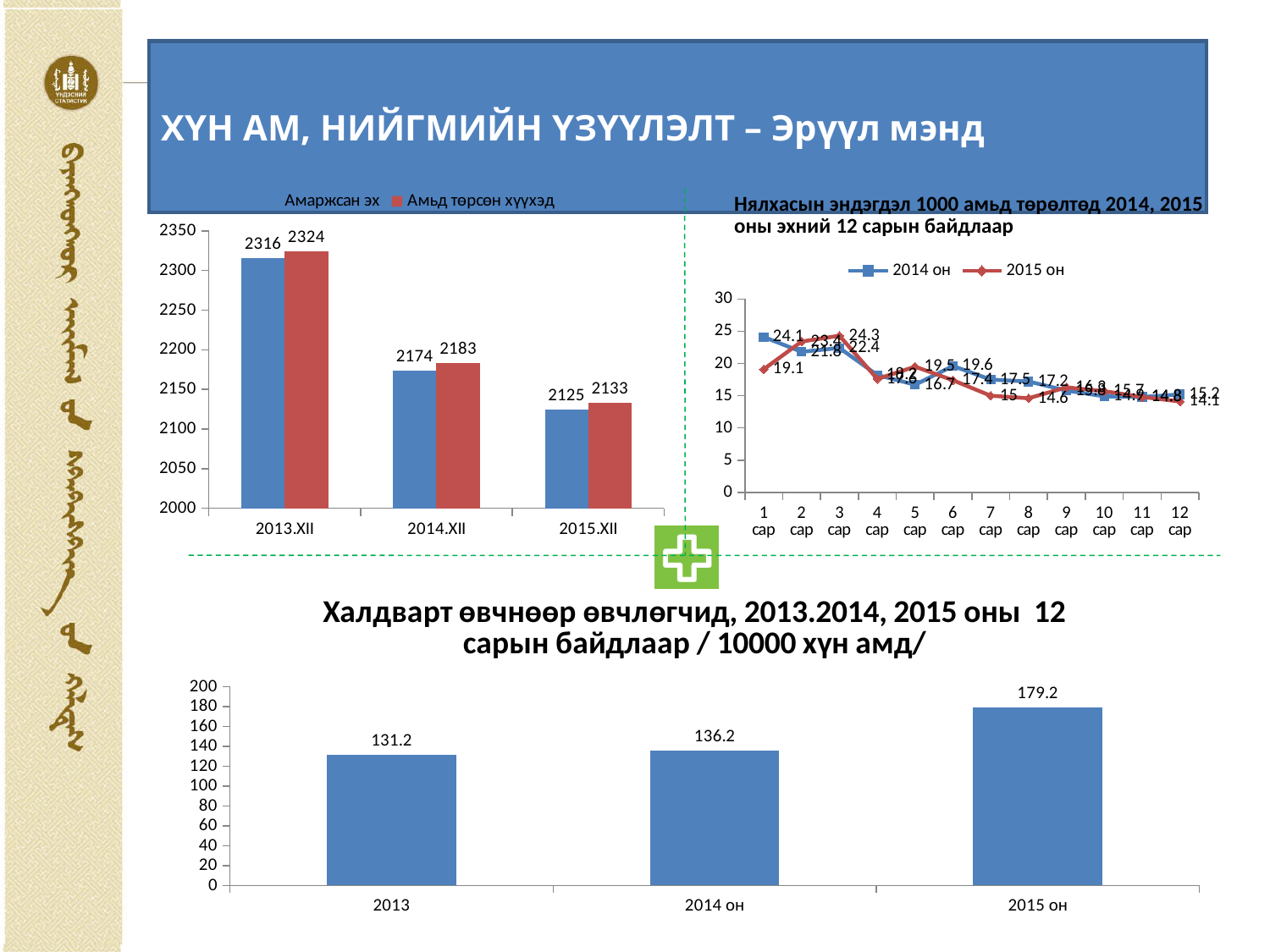
In the chart titled 'Нялхасын эндэгдэл 1000 амьд төрөлтөд 2014, 2015 оны эхний 12 сарын байдлаар', what is the value for 2015 он in 1 сар? 19.1 In the chart titled 'Нялхасын эндэгдэл 1000 амьд төрөлтөд 2014, 2015 оны эхний 12 сарын байдлаар', what is the value for 2014 он in 1 сар? 24.1 In the chart titled 'Халдварт өвчнөөр өвчлөгчид, 2013.2014, 2015 оны 12 сарын байдлаар / 10000 хүн амд/', what is the value for 2015 он? 179.2 In the chart titled 'Халдварт өвчнөөр өвчлөгчид, 2013.2014, 2015 оны 12 сарын байдлаар / 10000 хүн амд/', do the values rise or fall from 2013 to 2015 он? Rise In the chart titled 'Халдварт өвчнөөр өвчлөгчид, 2013.2014, 2015 оны 12 сарын байдлаар / 10000 хүн амд/', what is the difference between 2015 он and 2013? 48 In the top-left bar chart, what is the value of Амьд төрсөн хүүхэд for 2015.XII? 2133 In the top-left bar chart, what is the value of Амаржсан эх for 2013.XII? 2316 In the top-left bar chart, what is the difference between Амьд төрсөн хүүхэд and Амаржсан эх for 2014.XII? 9 In the chart titled 'Нялхасын эндэгдэл 1000 амьд төрөлтөд 2014, 2015 оны эхний 12 сарын байдлаар', how many months are shown on the x axis? 12 In the top-left bar chart, how many series does the legend list? 2 What kind of chart is the one titled 'Нялхасын эндэгдэл 1000 амьд төрөлтөд 2014, 2015 оны эхний 12 сарын байдлаар'? Line chart In the top-left bar chart, which period has the lowest value for Амаржсан эх? 2015.XII